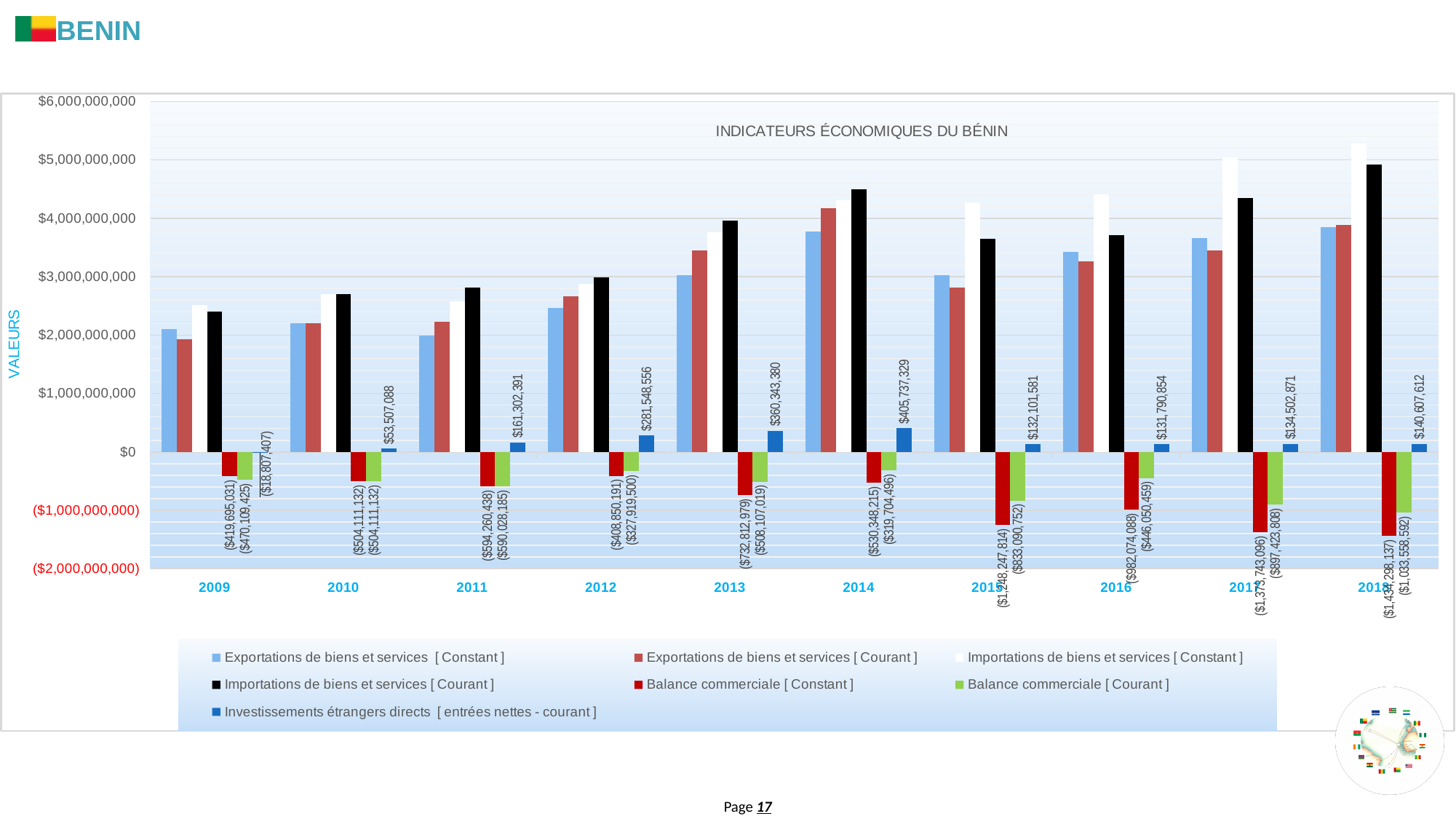
Which year has the Balance commerciale [Constant] value further below zero, 2015 or 2016? 2015 Is the value of Exportations de biens et services [Constant] for 2009 greater or less than $3,000,000,000? less What is the value of Investissements étrangers directs for 2014? $405,737,329 How many series does the chart legend list? 7 What is the difference between Investissements étrangers directs in 2013 and in 2012? $78,794,824 What is the title of the chart? INDICATEURS ÉCONOMIQUES DU BÉNIN What kind of chart is shown on the slide? Bar chart What is the value of Balance commerciale [Constant] for 2018? ($1,434,298,137) What is the value of Balance commerciale [Courant] for 2012? ($327,919,500) How many years are shown on the x axis of the chart? 10 In which year is Investissements étrangers directs highest? 2014 Is the value of Importations de biens et services [Courant] for 2018 greater or less than $4,000,000,000? greater